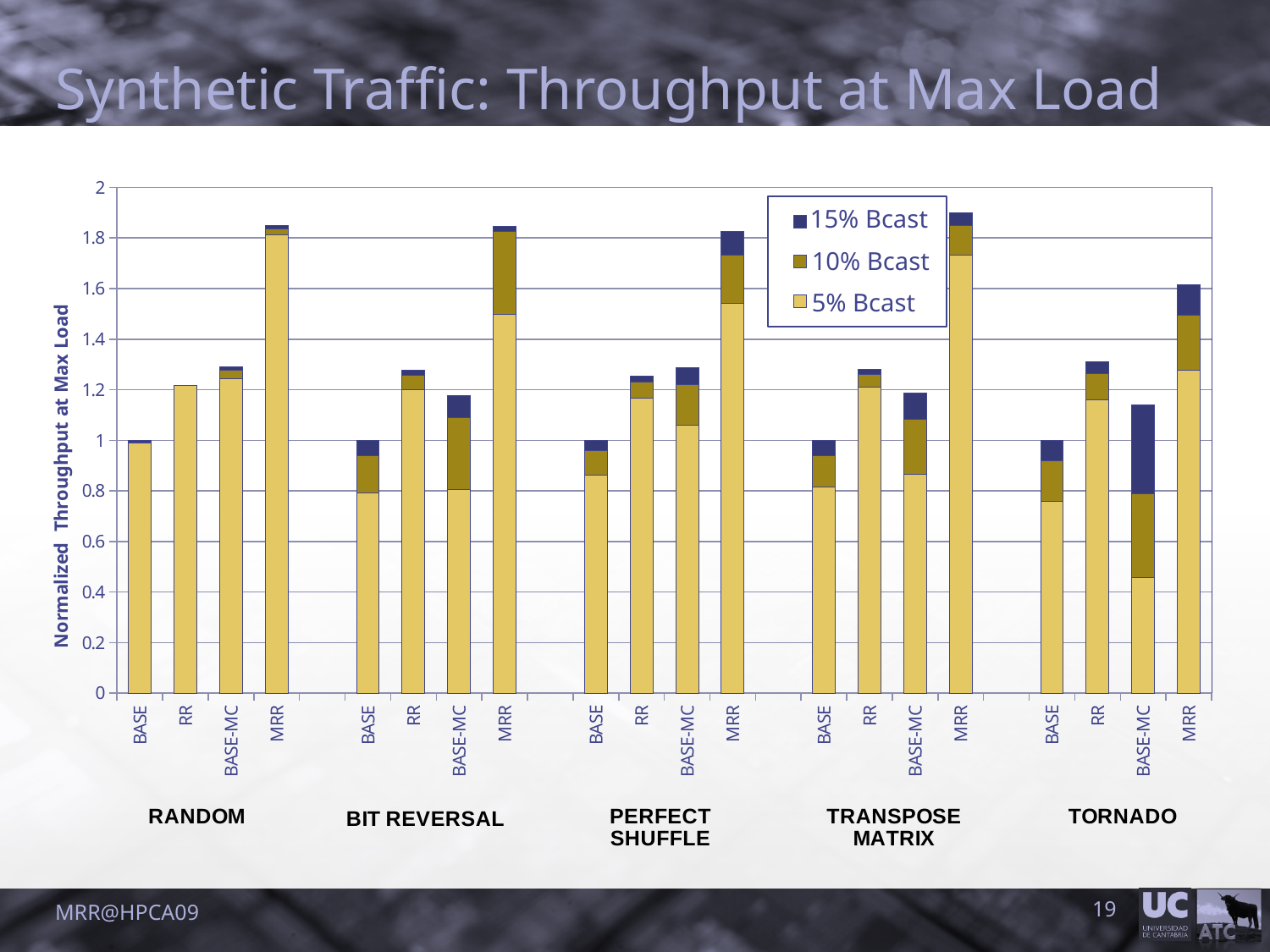
Is the total bar for MRR under RANDOM greater or less than 1.6? greater Is the total bar for MRR under TORNADO greater or less than 1.4? greater What kind of chart is shown on the slide? Bar chart What is the label on the vertical axis? Normalized Throughput at Max Load Within the TORNADO group, which configuration has the tallest bar? MRR Under PERFECT SHUFFLE, which has the taller bar: BASE-MC or MRR? MRR Is the total bar for BASE-MC under TORNADO greater or less than 1.2? less How many series does the legend list? 3 How many bars are plotted in total on the chart? 20 How many traffic pattern groups are shown along the x axis? 5 What are the three series named in the legend? 15% Bcast, 10% Bcast, 5% Bcast